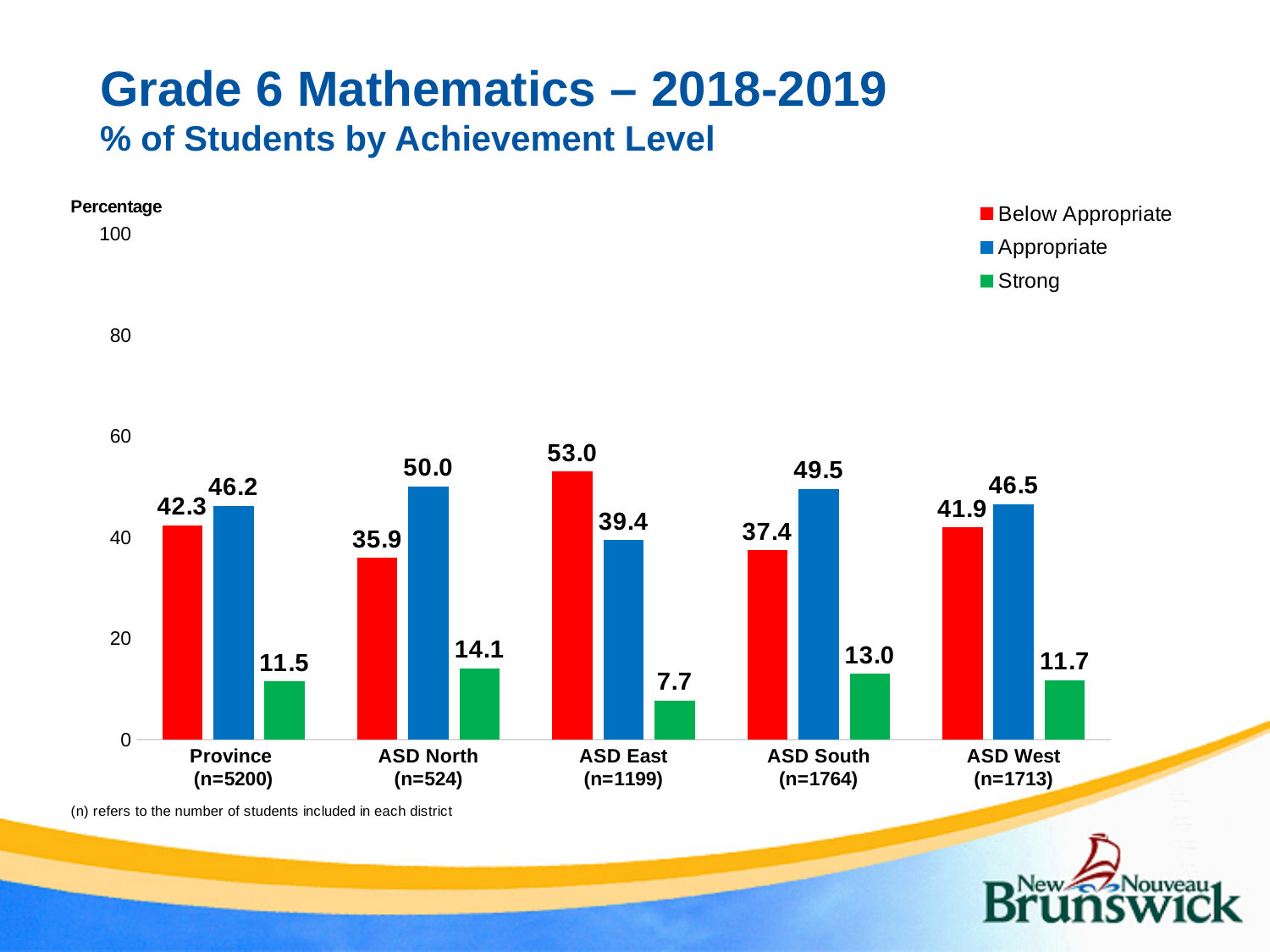
Which district has the highest Below Appropriate percentage? ASD East Which is larger, the Below Appropriate value for ASD South or for ASD West? ASD West Is the Appropriate value for ASD South greater or less than 40? greater What is the difference between the Appropriate percentages for ASD North and ASD East? 10.6 Which colour represents the Strong series in the legend? green How many categories are shown on the x axis? 5 What is the Strong percentage for ASD North? 14.1 What is the Below Appropriate percentage for ASD East? 53.0 How many series does the legend list? 3 What is the Appropriate percentage for the Province? 46.2 Which category has the lowest Strong percentage? ASD East What kind of chart is shown on the slide? bar chart